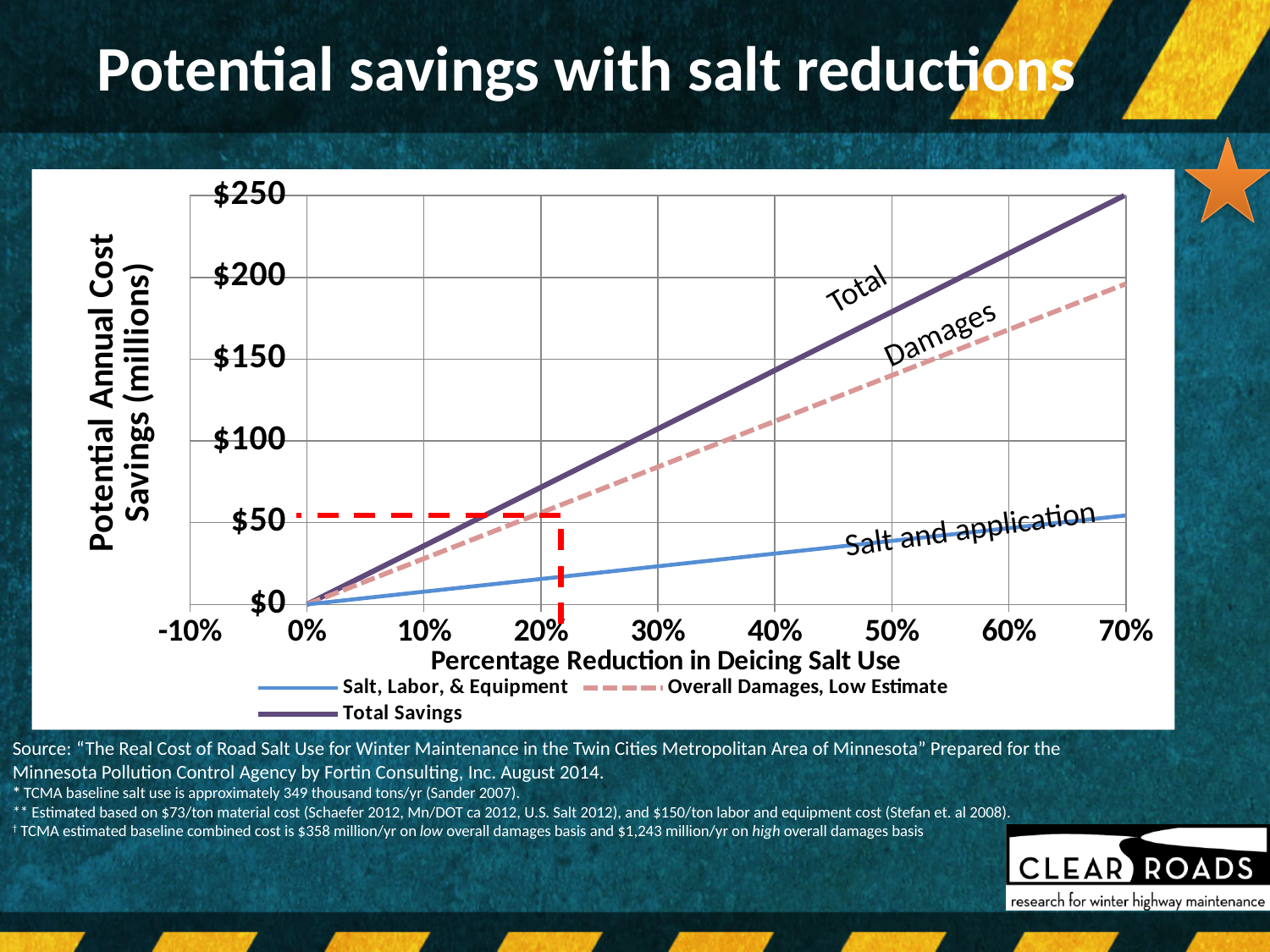
Which series has the lowest value at a 70% reduction? Salt, Labor, & Equipment How many series does the chart legend list? 3 What kind of chart is shown on the slide? line chart What is the label of the x axis? Percentage Reduction in Deicing Salt Use At a 50% reduction, which is larger: Total Savings or Overall Damages, Low Estimate? Total Savings What is the title of the slide's chart? Potential savings with salt reductions Is the Overall Damages, Low Estimate value at a 40% reduction greater or less than $100? greater How many tick labels are shown on the x axis? 9 Do the Total Savings values rise or fall as the percentage reduction increases? rise Which series has the highest value at a 70% reduction? Total Savings Is the Salt, Labor, & Equipment value at a 40% reduction greater or less than $50? less Is the Total Savings value at a 60% reduction greater or less than $200? greater